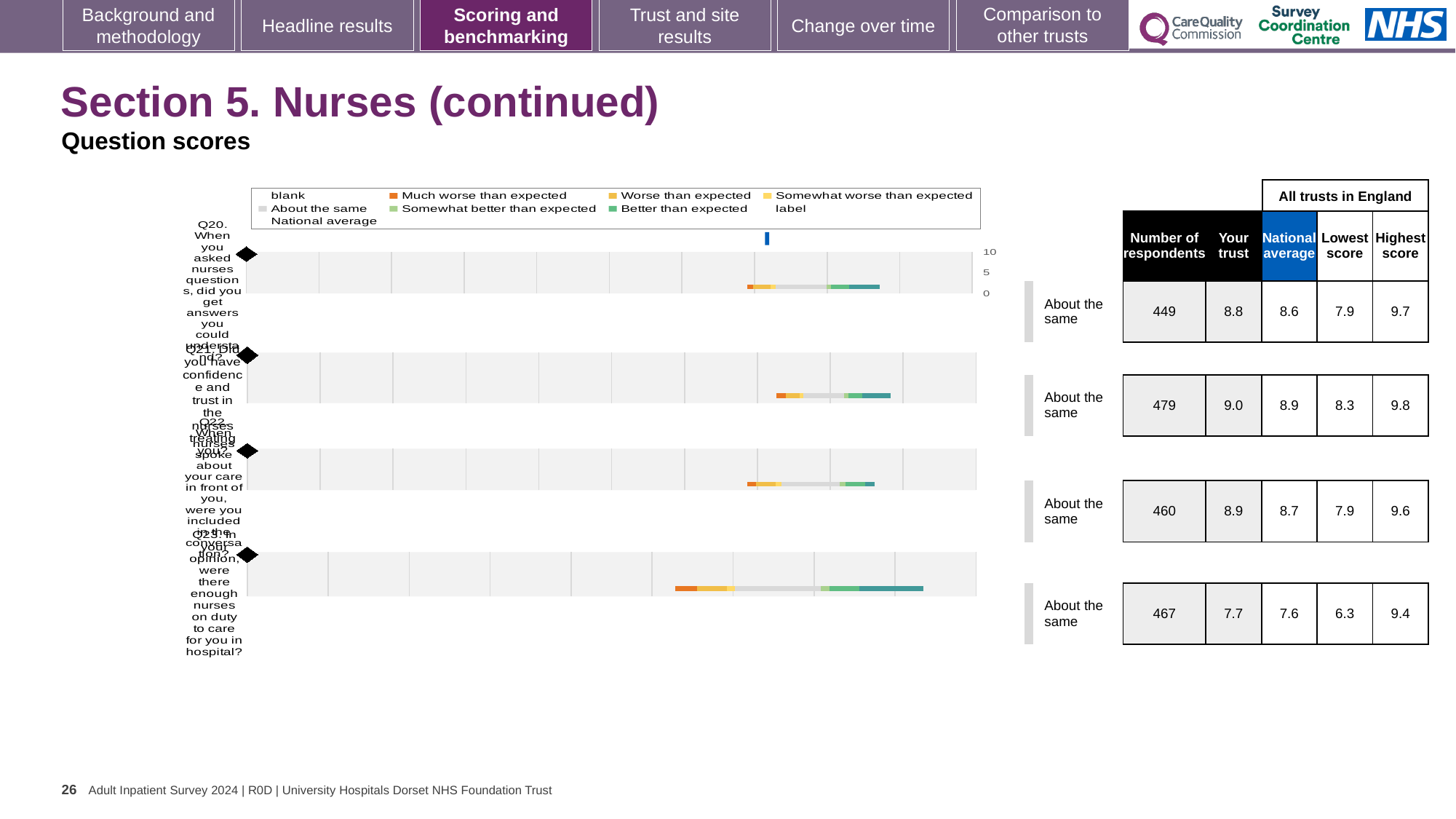
What is the 'Your trust' score for Q21 (confidence and trust in the nurses)? 9.0 Which question has the lowest 'Your trust' score? Q23 How many respondents answered Q20 (answers you could understand)? 449 Which question has the highest 'Your trust' score? Q21 How many questions (Q20 to Q23) are plotted on the slide? 4 What is the national average score for Q23 (enough nurses on duty)? 7.6 What is the highest score among all trusts in England for Q21? 9.8 For Q20, how much higher is the 'Your trust' score than the national average? 0.2 What is the lowest score among all trusts in England for Q23? 6.3 What kind of chart is used to show the question scores for Q20 to Q23? Bar chart For Q22, which is larger: the 'Your trust' score or the national average? Your trust What benchmark category is shown for Q23 (enough nurses on duty)? About the same